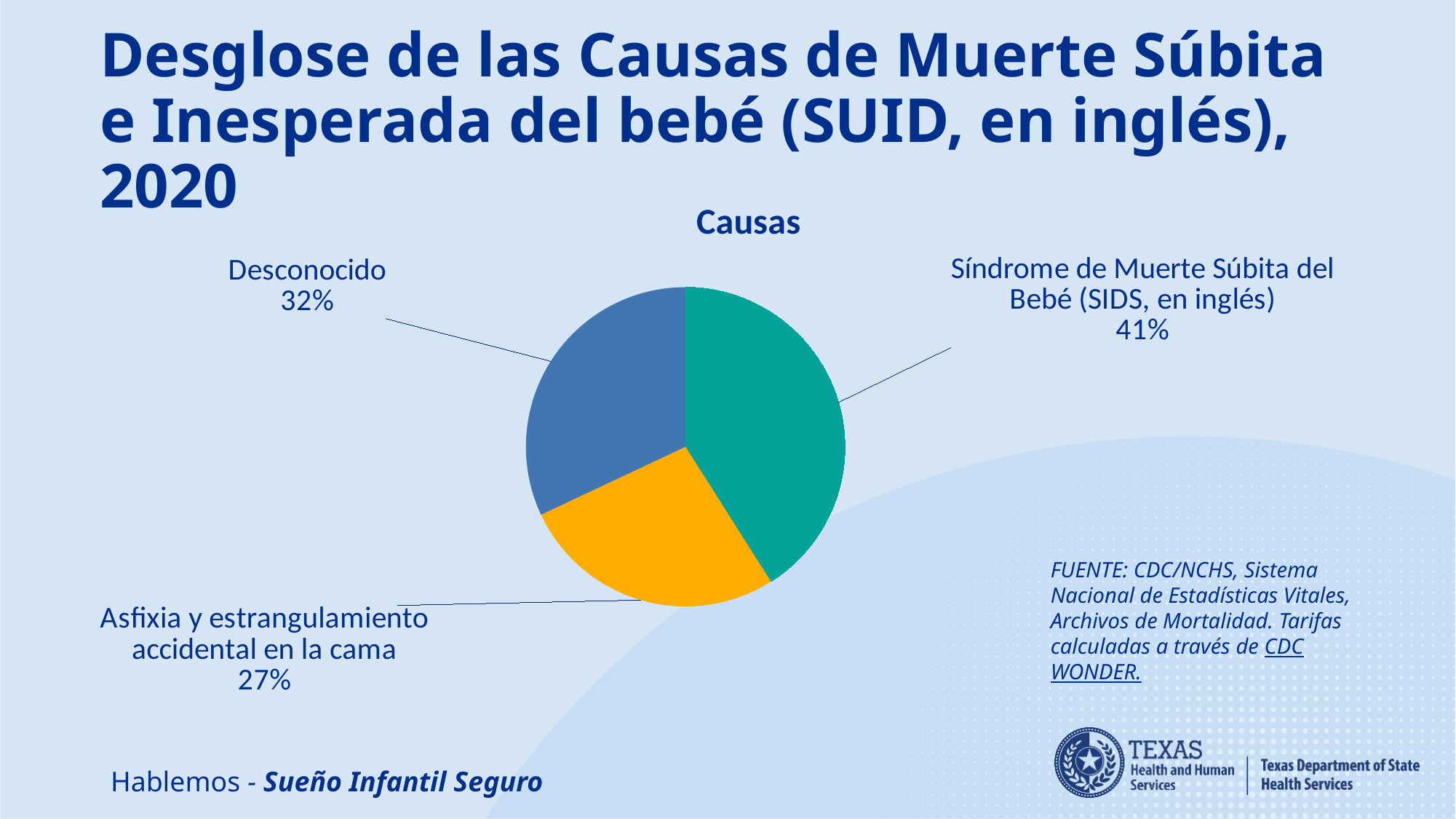
How many slices does the pie chart have? 3 What is the difference in percentage points between the Desconocido slice and the Asfixia y estrangulamiento accidental en la cama slice? 5 What percentage is shown for Síndrome de Muerte Súbita del Bebé (SIDS, en inglés)? 41% What is the difference in percentage points between the SIDS slice and the Desconocido slice? 9 Which cause has the largest share of the pie? Síndrome de Muerte Súbita del Bebé (SIDS, en inglés) What is the title of the chart? Causas What percentage is shown for Asfixia y estrangulamiento accidental en la cama? 27% What type of chart is shown on the slide? pie chart What percentage of the pie is labelled Desconocido? 32% Which cause has the smallest share of the pie? Asfixia y estrangulamiento accidental en la cama Which is larger: the Desconocido slice or the Asfixia y estrangulamiento accidental en la cama slice? Desconocido What colour is the slice for Síndrome de Muerte Súbita del Bebé (SIDS, en inglés)? teal (green)